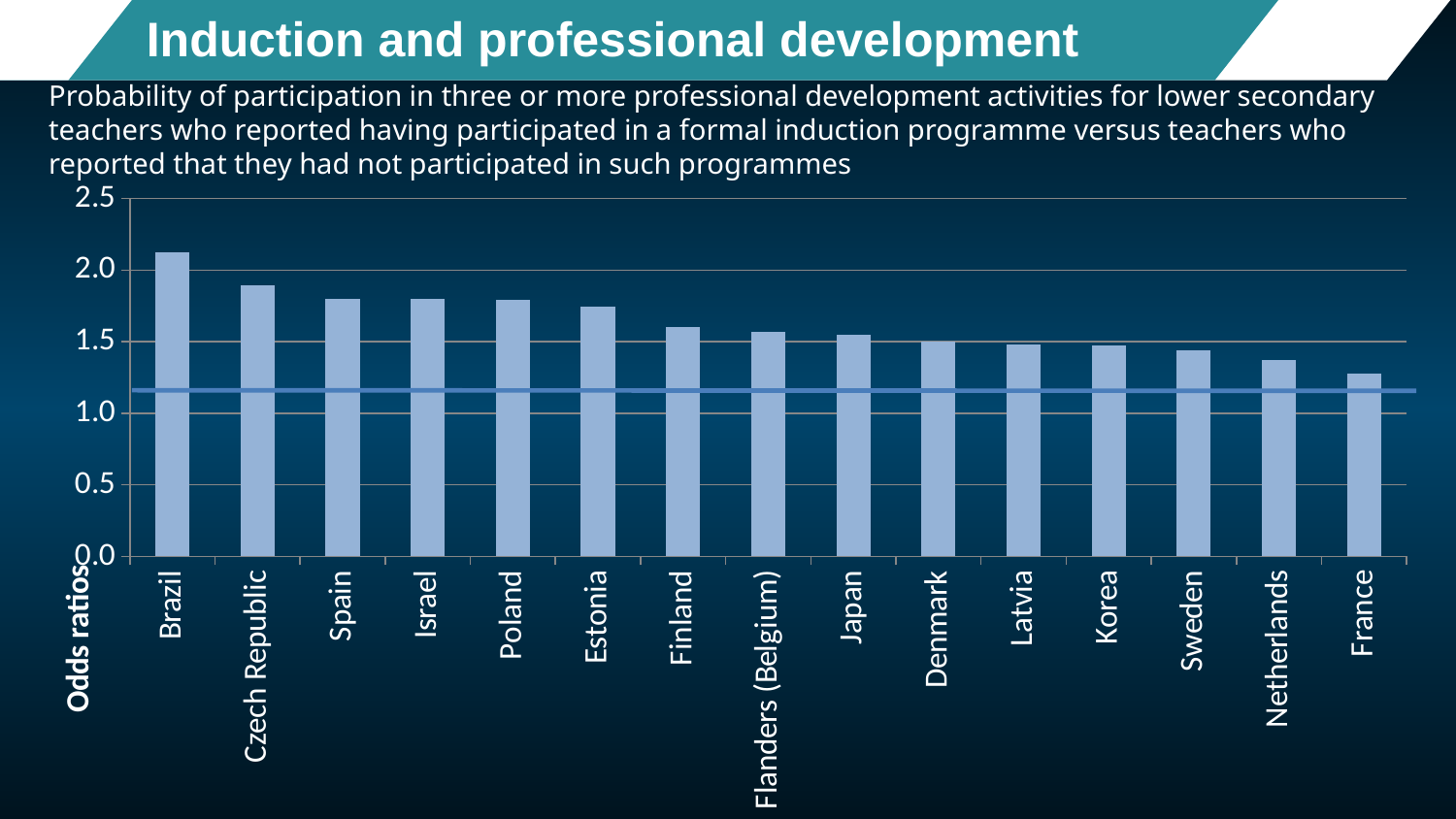
Which country has the lowest odds ratio? France How many countries or regions are shown on the x axis? 15 Do the bar values rise or fall from left to right along the x axis? fall Which country has the highest odds ratio? Brazil What kind of chart is shown on the slide? bar chart Is the value for Netherlands greater or less than 1.5? less Is the value for Spain greater or less than 1.5? greater Is the value for France greater or less than 1.0? greater Which has a larger odds ratio, Czech Republic or Poland? Czech Republic What is the label on the vertical axis? Odds ratios